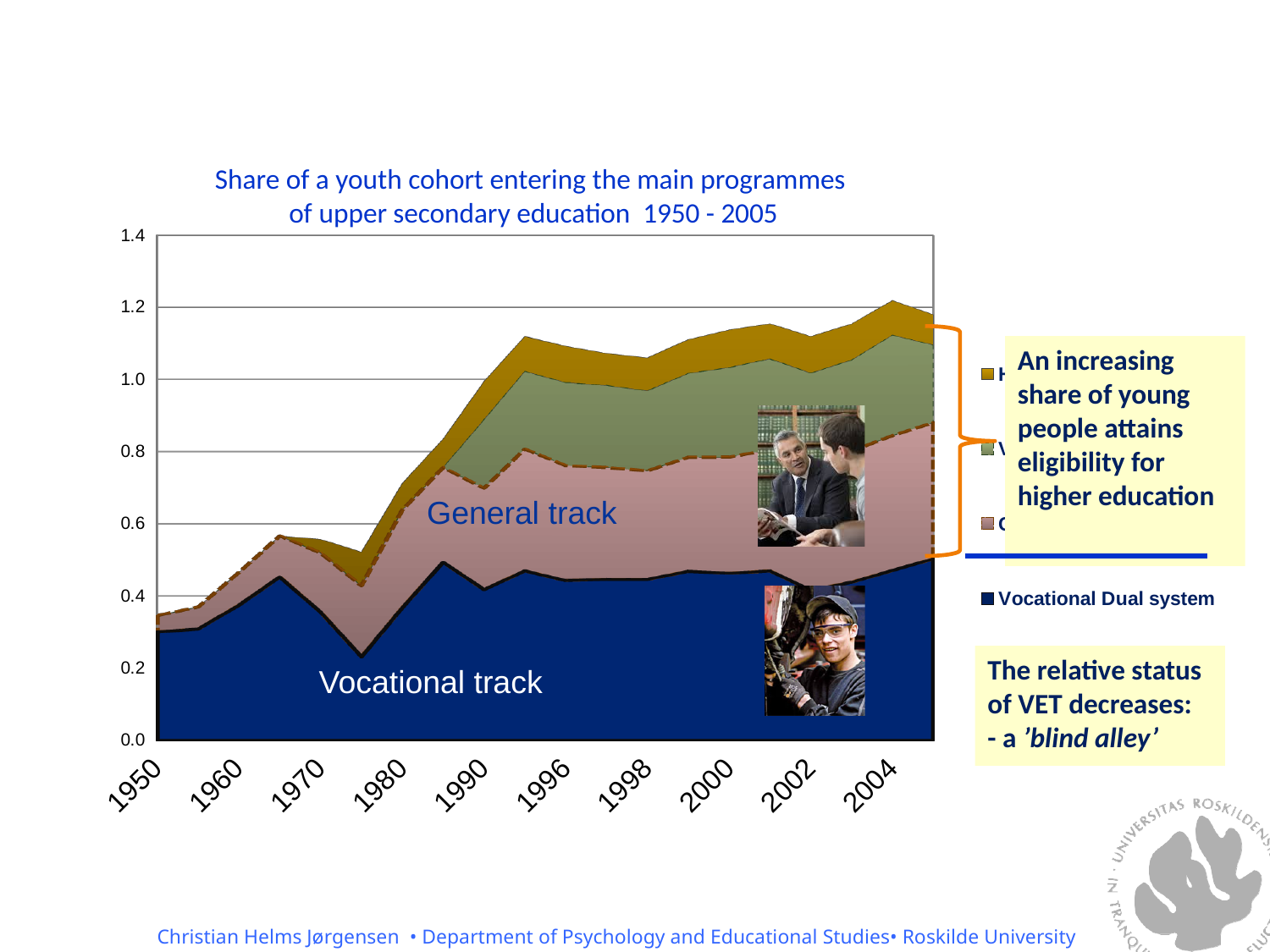
Does the total stacked value generally rise or fall from 1950 to 2004? rise How many year labels are shown on the x axis? 10 Is the total stacked value in 1950 greater or less than 0.4? less Is the total stacked value in 2004 greater or less than 1.0? greater Which legend entry is fully readable at the bottom of the legend? Vocational Dual system Is the value for the Vocational Dual system in 1980 greater or less than 0.4? less What kind of chart is shown on the slide? area chart What is the title of the chart? Share of a youth cohort entering the main programmes of upper secondary education 1950 - 2005